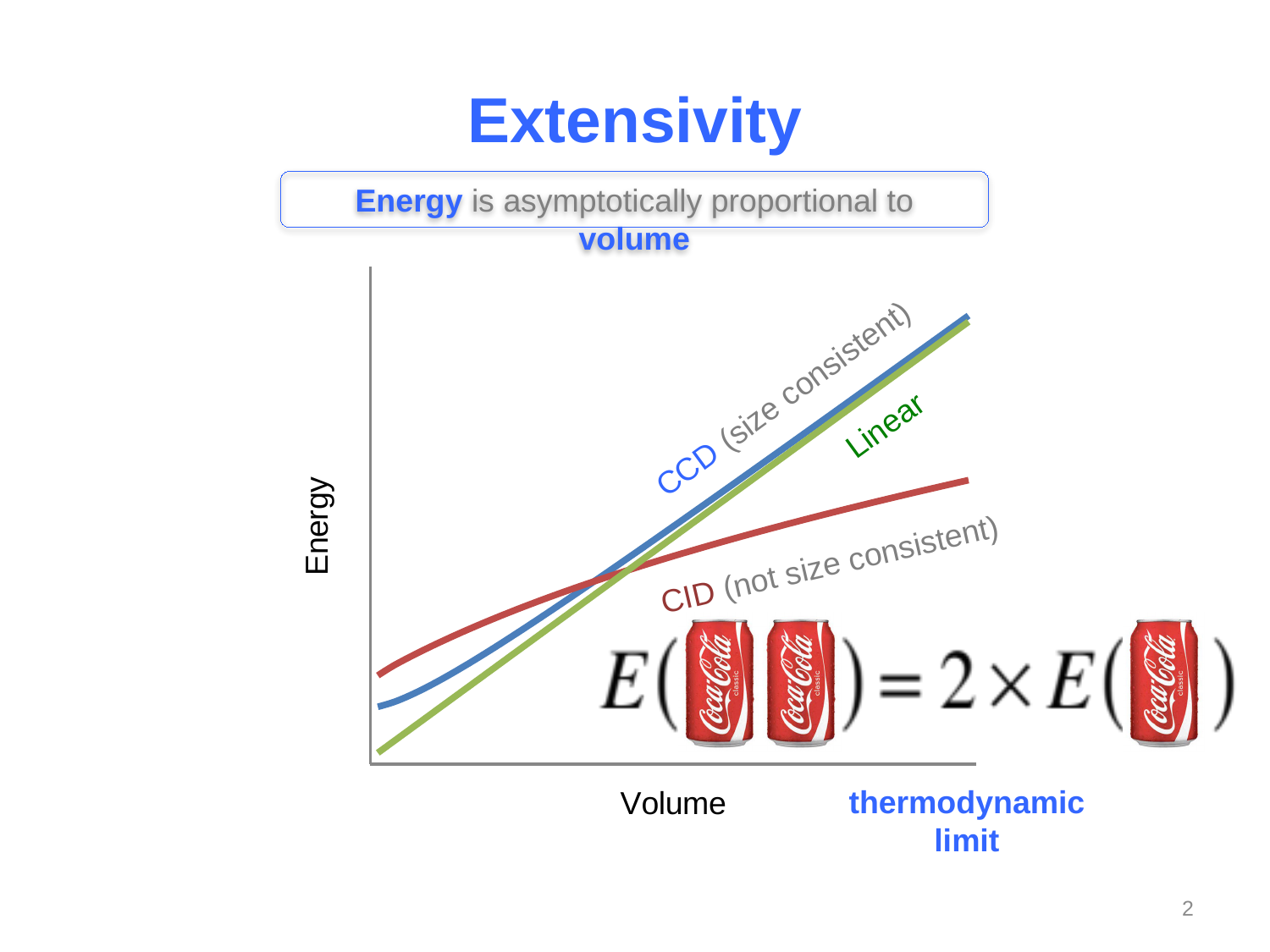
At the right-hand end of the chart, which is higher: the CCD (size consistent) line or the CID (not size consistent) line? CCD (size consistent) Does the CID (not size consistent) line rise or fall as volume increases? rise Does the CCD (size consistent) line rise or fall as volume increases? rise What is the label of the y axis of the chart? Energy What is the label of the x axis of the chart? Volume How many lines are plotted on the chart? 3 At the left-hand end of the chart, which is higher: the CID (not size consistent) line or the Linear line? CID (not size consistent) Which line is highest at the left-hand end of the chart? CID (not size consistent) What kind of chart is shown on the slide? line chart Which line is lowest at the right-hand end of the chart? CID (not size consistent) Which line is lowest at the left-hand end of the chart? Linear